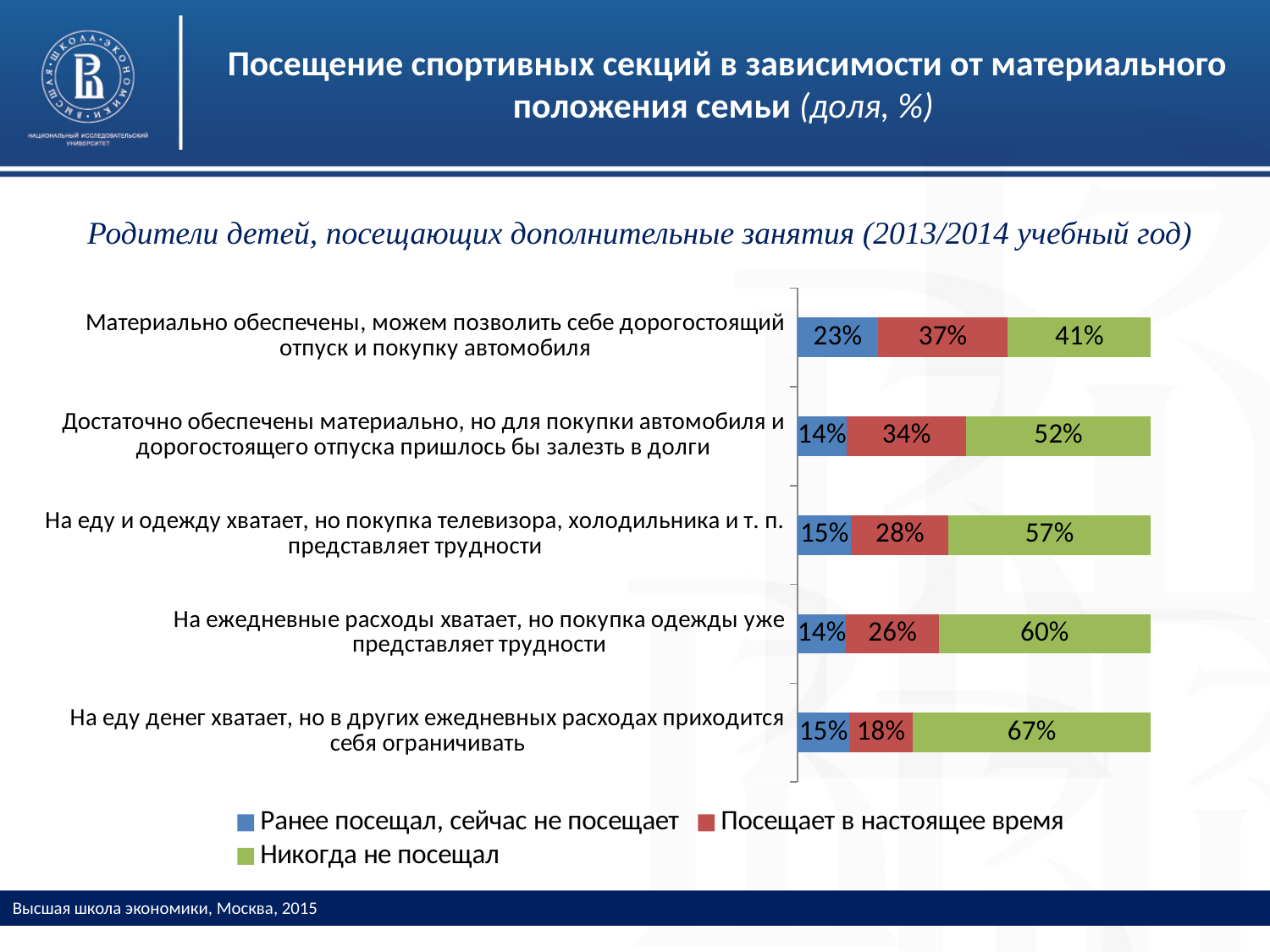
Does the share of "Никогда не посещал" rise or fall going from the top category (most affluent) to the bottom category (least affluent)? rises Which category has the highest value for "Никогда не посещал"? На еду денег хватает, но в других ежедневных расходах приходится себя ограничивать What is the difference between the "Никогда не посещал" values for "На ежедневные расходы хватает, но покупка одежды уже представляет трудности" and "Материально обеспечены, можем позволить себе дорогостоящий отпуск и покупку автомобиля"? 19% What type of chart is shown on the slide? stacked bar chart Which is larger: "Посещает в настоящее время" for "На еду и одежду хватает, но покупка телевизора, холодильника и т. п. представляет трудности" or for "На ежедневные расходы хватает, но покупка одежды уже представляет трудности"? На еду и одежду хватает, но покупка телевизора, холодильника и т. п. представляет трудности What is the value of "Ранее посещал, сейчас не посещает" for the category "Достаточно обеспечены материально, но для покупки автомобиля и дорогостоящего отпуска пришлось бы залезть в долги"? 14% Which category has the lowest value for "Посещает в настоящее время"? На еду денег хватает, но в других ежедневных расходах приходится себя ограничивать How many categories (family financial situations) are shown in the chart? 5 What is the value of "Посещает в настоящее время" for the category "Материально обеспечены, можем позволить себе дорогостоящий отпуск и покупку автомобиля"? 37% What is the value of "Никогда не посещал" for the category "На еду денег хватает, но в других ежедневных расходах приходится себя ограничивать"? 67% Which colour represents the series "Никогда не посещал" in the chart? green How many series does the legend list? 3